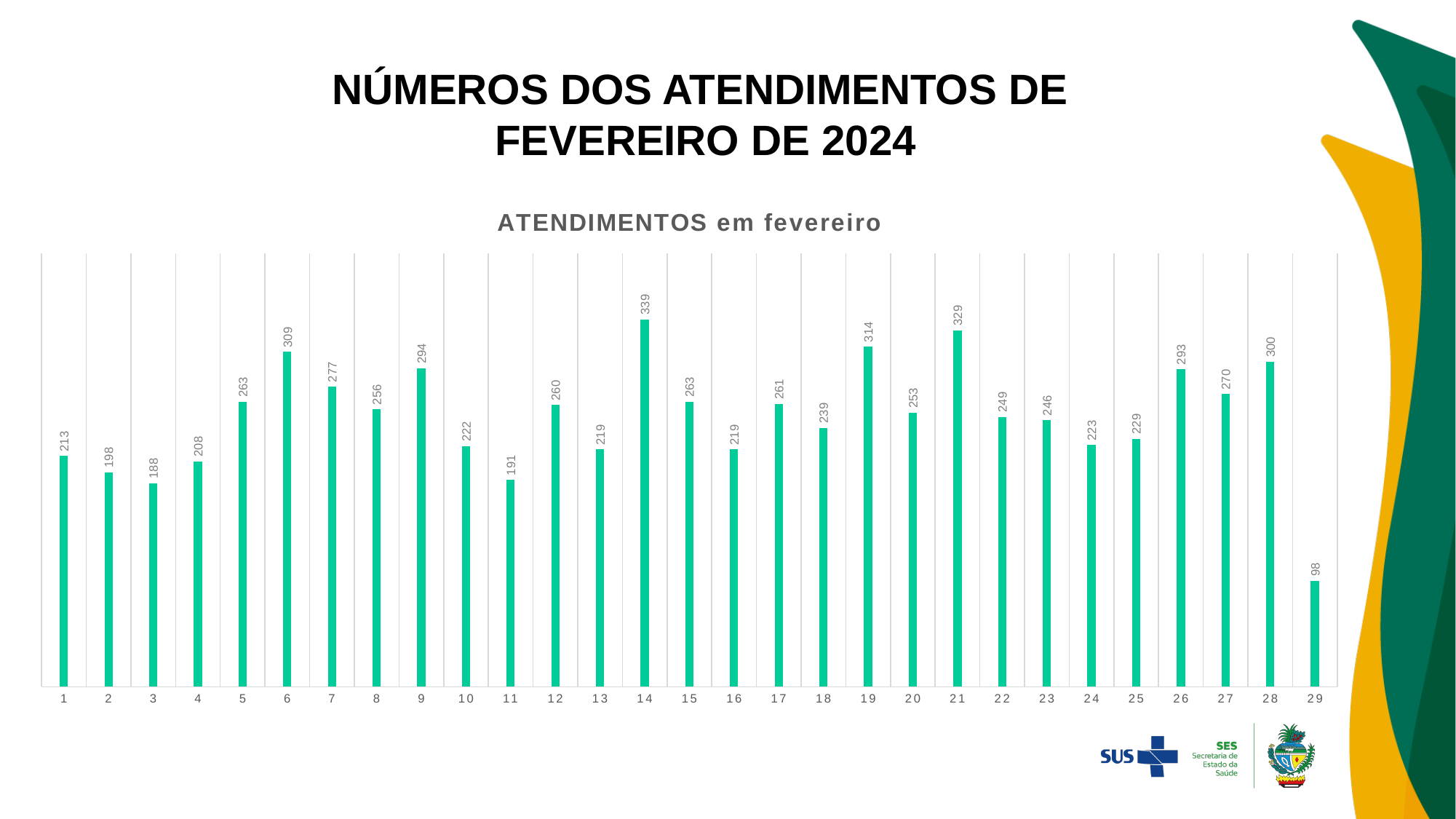
What is the difference between the values for day 1 and day 29? 115 What is the value for day 29? 98 Which is larger, the value for day 19 or the value for day 26? day 19 What is the value for day 14? 339 What is the title of the chart? ATENDIMENTOS em fevereiro What is the value for day 6? 309 Which is larger, the value for day 3 or the value for day 11? day 11 Which day has the lowest value? 29 What kind of chart is shown? bar chart What is the difference between the values for day 14 and day 21? 10 How many days are shown on the x axis? 29 Which day has the highest value? 14